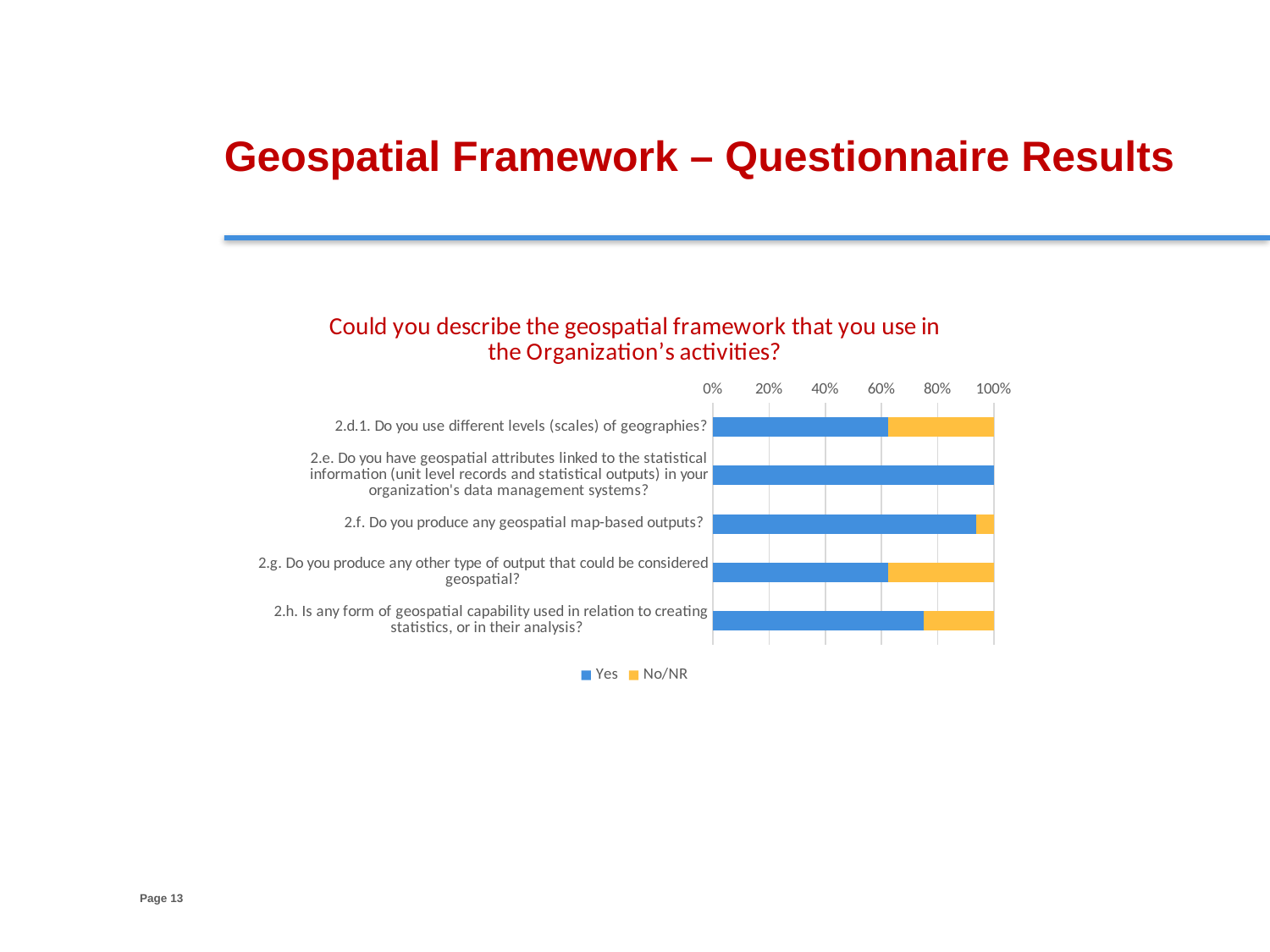
How many questions (categories) are plotted in the chart? 5 How many series does the legend list? 2 Which question has the highest Yes share? 2.e. Do you have geospatial attributes linked to the statistical information (unit level records and statistical outputs) in your organization's data management systems? What kind of chart is shown on the slide? bar chart What is the title of the chart? Could you describe the geospatial framework that you use in the Organization's activities? Which has the larger Yes share, question 2.e or question 2.g? 2.e What is the Yes share for question 2.e? 100% Is the Yes share for question 2.d.1 greater or less than 80%? less Is the Yes share for question 2.h greater or less than 60%? greater Which has the larger Yes share, question 2.f or question 2.h? 2.f Is the Yes share for question 2.f greater or less than 80%? greater What are the two series named in the legend? Yes and No/NR